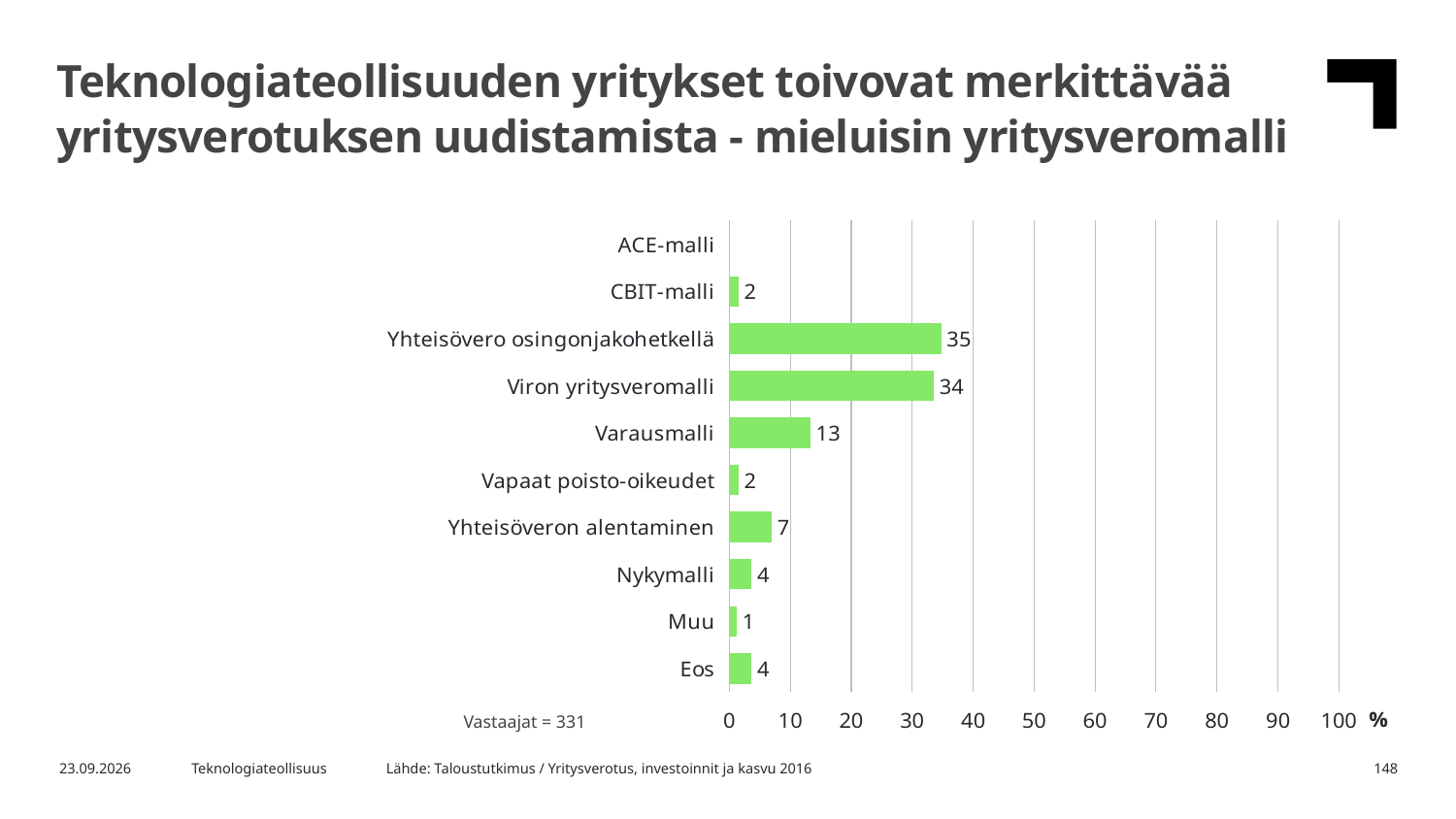
What is the value for Viron yritysveromalli? 34 How many categories are shown on the chart? 10 What kind of chart is shown on the slide? bar chart What is the difference between the values for Yhteisövero osingonjakohetkellä and Viron yritysveromalli? 1 What is the value for Muu? 1 Which is larger, the value for Nykymalli or the value for Yhteisöveron alentaminen? Yhteisöveron alentaminen What is the difference between the values for Varausmalli and Yhteisöveron alentaminen? 6 What is the value for Yhteisövero osingonjakohetkellä? 35 What is the value for Yhteisöveron alentaminen? 7 Is the value for Varausmalli greater or less than 10? greater Which category has the highest value? Yhteisövero osingonjakohetkellä What is the value for Varausmalli? 13